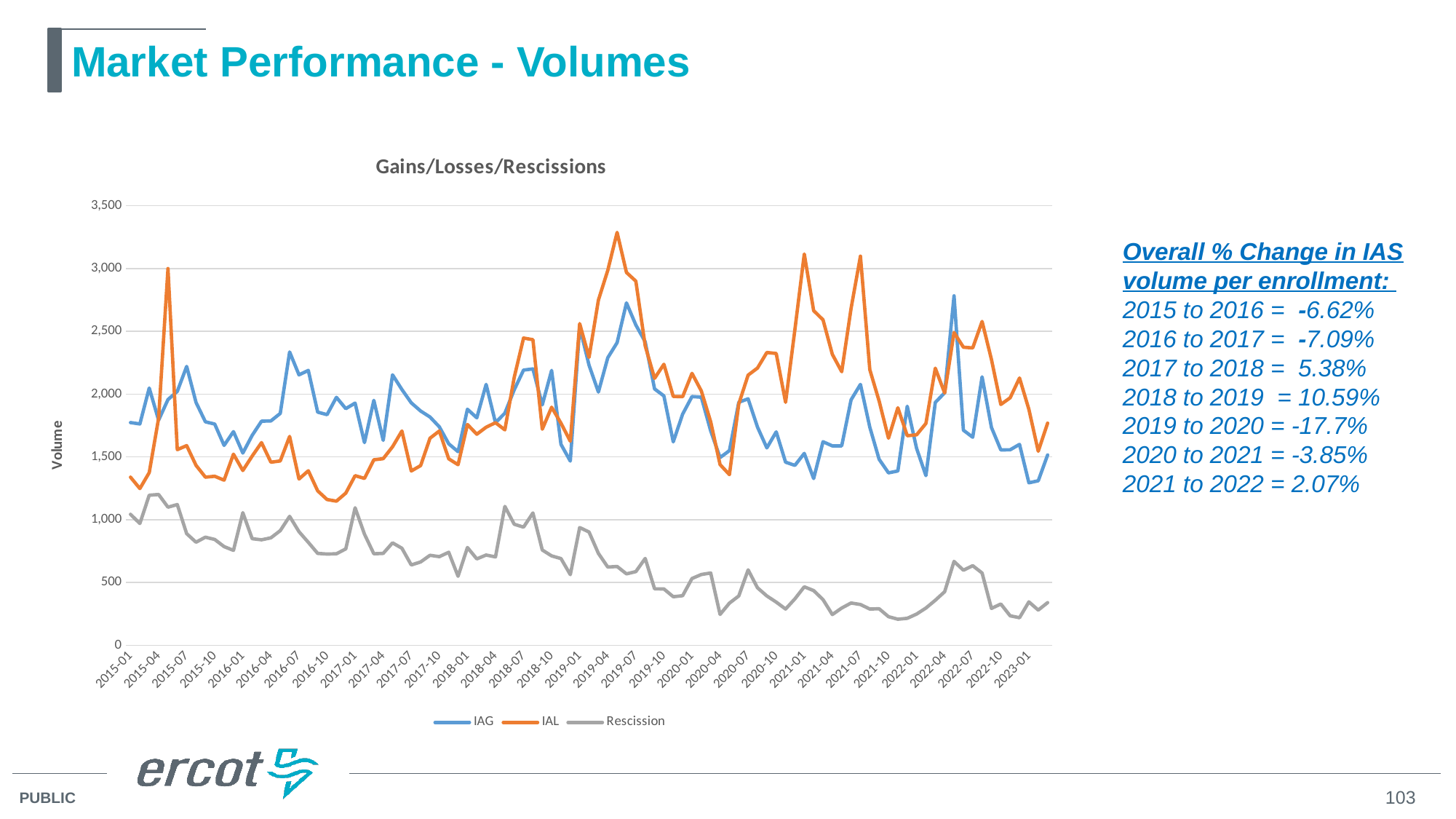
Which series is higher at 2019-07, IAG or IAL? IAL How many series does the legend of the chart list? 3 Is the value of the IAG series at 2016-07 greater or less than 2,000? greater What kind of chart is shown on the slide? line chart What is the title of the chart? Gains/Losses/Rescissions Which series has the lowest values throughout the chart? Rescission Which series is higher at 2016-07, IAG or IAL? IAG Is the value of the IAL series at 2016-10 greater or less than 1,500? less Is the peak value of the IAL series around 2019-07 greater or less than 3,000? greater Does the Rescission series generally rise or fall from 2015-01 to 2023-01? fall Which colour is used for the IAL series in the chart? orange